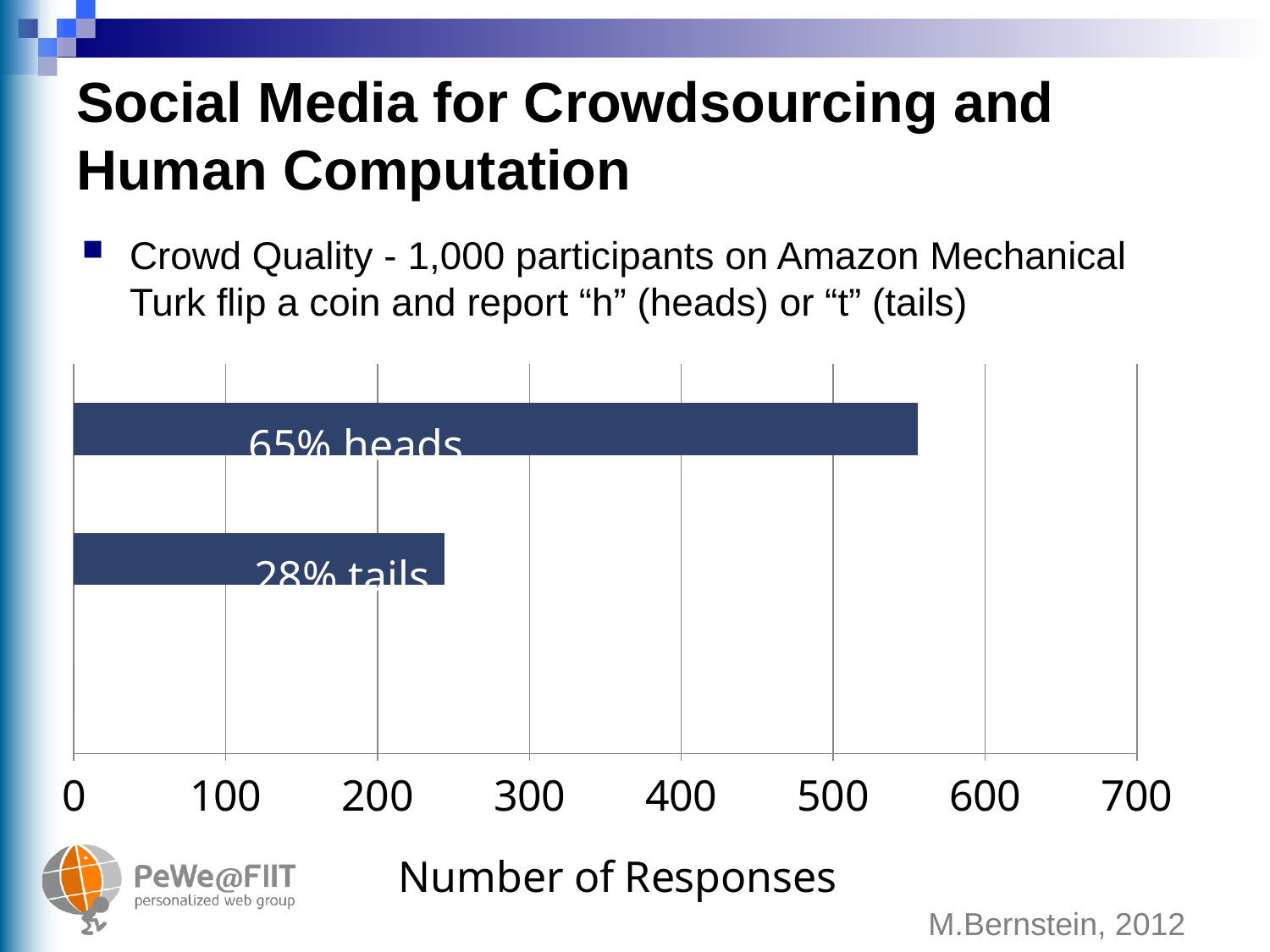
Which bar is the longest in the chart? 65% heads Which bar is longer, the heads bar or the tails bar? heads Is the number of responses for tails greater or less than 200? greater Is the number of responses for heads greater or less than 600? less How many bars are plotted in the chart? 2 What is the highest value shown on the x axis of the chart? 700 Which bar is the shortest in the chart? 28% tails Is the number of responses for tails greater or less than 300? less What kind of chart is shown on the slide? bar chart What is the title of the x axis of the chart? Number of Responses